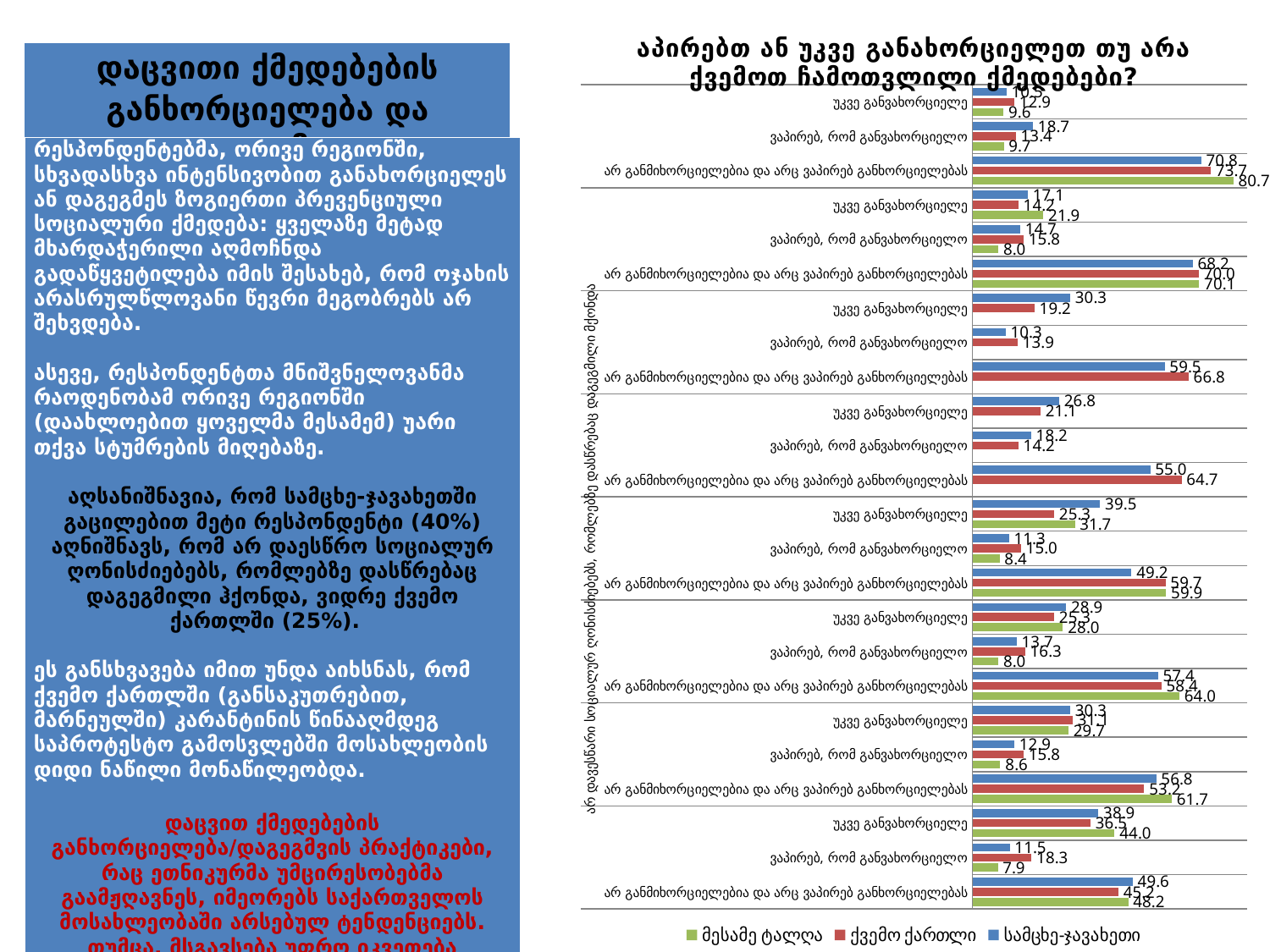
In the topmost group of bars, which series has the lowest value for 'ვაპირებ, რომ განვახორციელო'? მესამე ტალღა In the bottommost group of bars, what is the value of the blue (სამცხე-ჯავახეთი) bar for 'ვაპირებ, რომ განვახორციელო'? 11.5 How many series does the chart legend list? 3 Which series is shown in green in the chart legend? მესამე ტალღა In the topmost group of bars, what is the value of the red (ქვემო ქართლი) bar for 'უკვე განვახორციელე'? 12.9 In the topmost group of bars, what is the value of the green (მესამე ტალღა) bar for 'არ განმიხორციელებია და არც ვაპირებ განხორციელებას'? 80.7 In the topmost group of bars, which series has the highest value for 'არ განმიხორციელებია და არც ვაპირებ განხორციელებას'? მესამე ტალღა In the bottommost group of bars, which is larger for 'ვაპირებ, რომ განვახორციელო': the red (ქვემო ქართლი) bar or the green (მესამე ტალღა) bar? ქვემო ქართლი In the bottommost group of bars, what is the difference between the green (44.0) and red (36.5) bars for 'უკვე განვახორციელე'? 7.5 In the topmost group of bars, what is the difference between the green (80.7) and blue (70.8) bars for 'არ განმიხორციელებია და არც ვაპირებ განხორციელებას'? 9.9 What kind of chart is shown on the slide? bar chart In the bottommost group of bars, what is the value of the green (მესამე ტალღა) bar for 'უკვე განვახორციელე'? 44.0